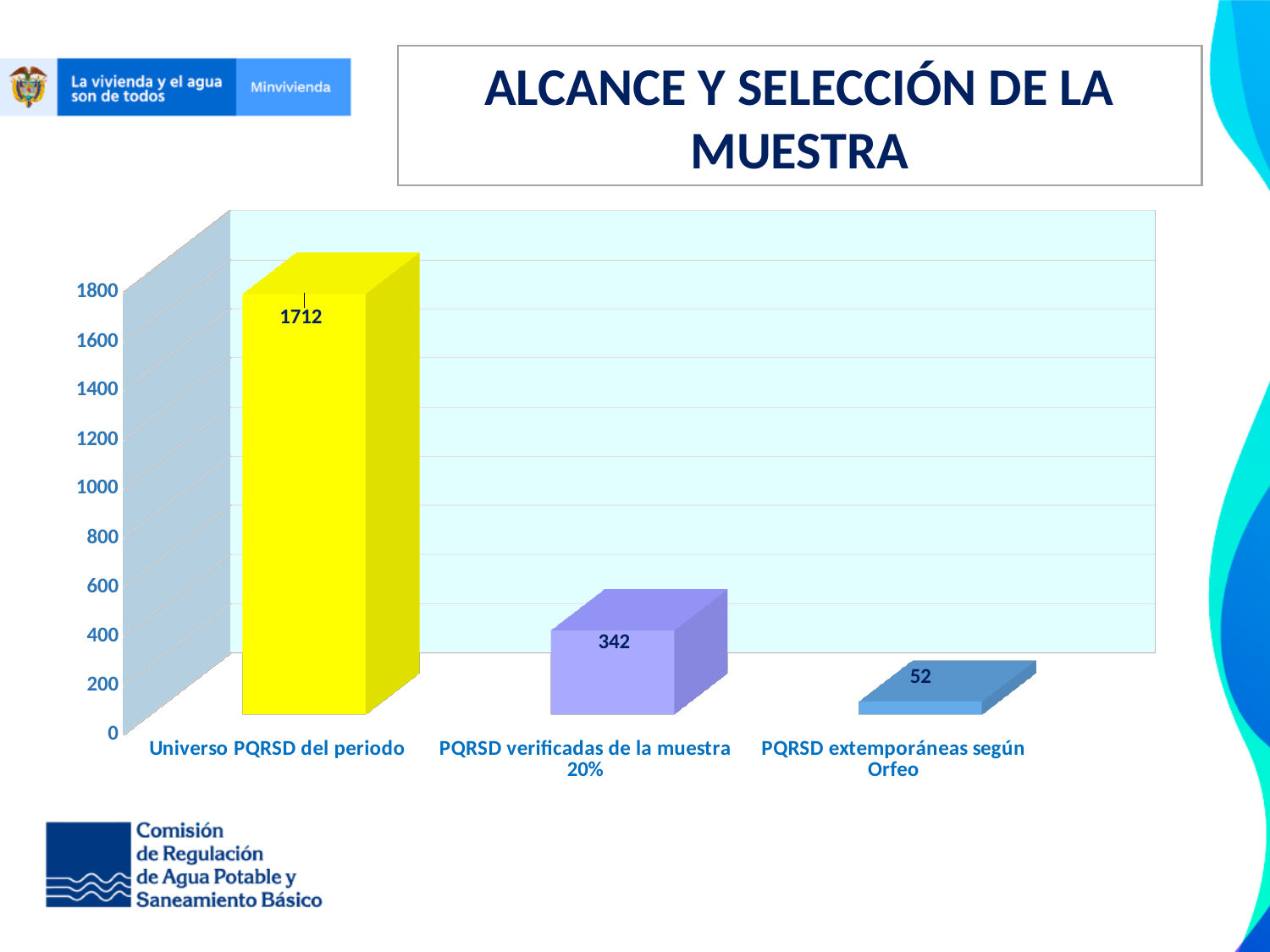
Is the value for Universo PQRSD del periodo greater or less than 1600? greater What is the difference between Universo PQRSD del periodo and PQRSD verificadas de la muestra 20%? 1370 What kind of chart is shown on the slide? bar chart What is the difference between PQRSD verificadas de la muestra 20% and PQRSD extemporáneas según Orfeo? 290 What is the value for PQRSD verificadas de la muestra 20%? 342 Which category has the highest value? Universo PQRSD del periodo How many categories are shown in the chart? 3 What is the value for Universo PQRSD del periodo? 1712 Do the values rise or fall from left to right across the categories? fall Which is larger, PQRSD verificadas de la muestra 20% or PQRSD extemporáneas según Orfeo? PQRSD verificadas de la muestra 20% Which category has the lowest value? PQRSD extemporáneas según Orfeo What is the value for PQRSD extemporáneas según Orfeo? 52